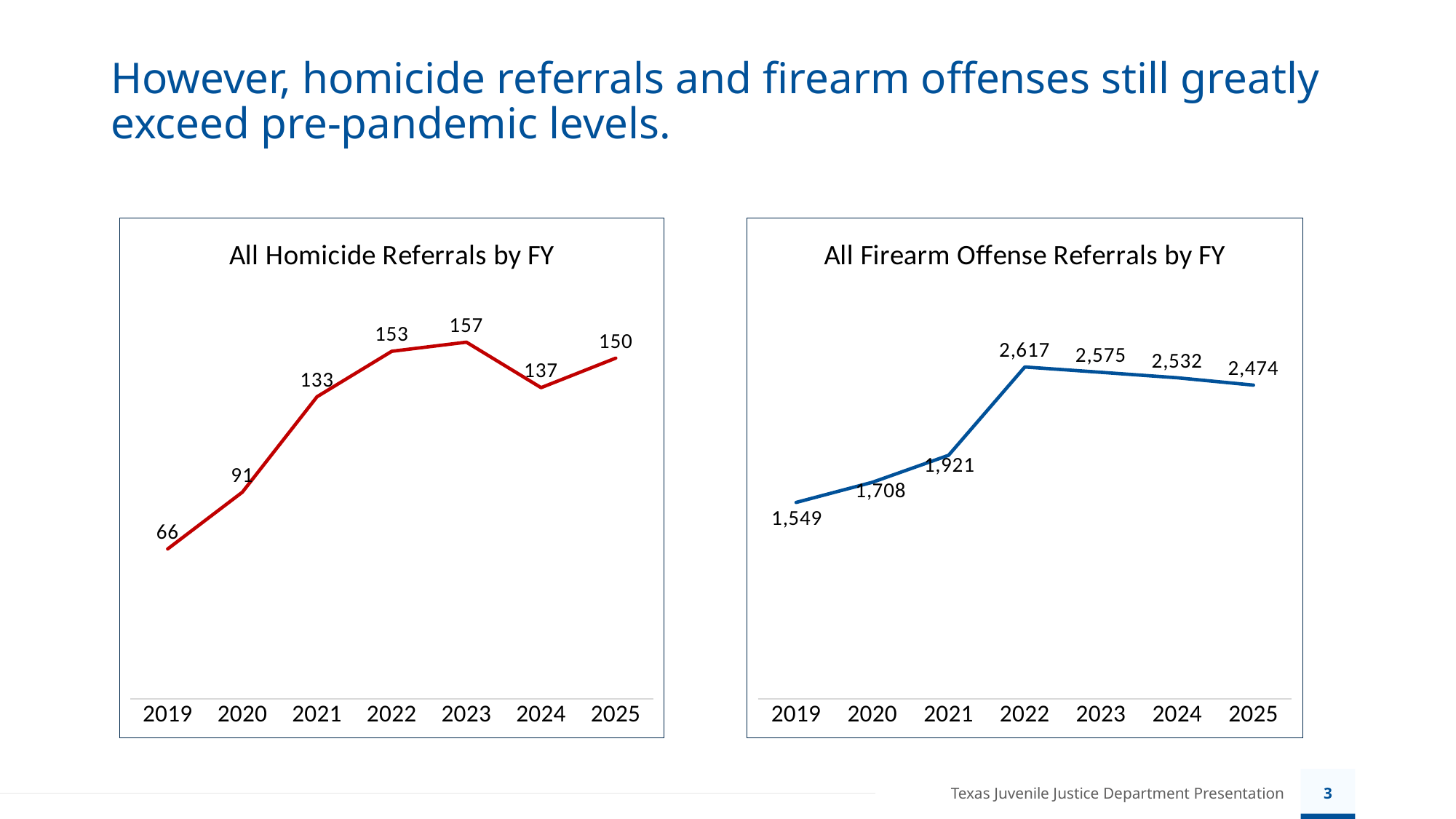
In the 'All Firearm Offense Referrals by FY' chart, which is larger, the value for 2020 or the value for 2021? 2021 In the 'All Firearm Offense Referrals by FY' chart, do the values rise or fall from 2022 to 2025? Fall In the 'All Firearm Offense Referrals by FY' chart, what is the value for 2022? 2,617 In the 'All Homicide Referrals by FY' chart, which year has the highest value? 2023 In the 'All Homicide Referrals by FY' chart, what is the difference between the 2025 value and the 2019 value? 84 How many years are plotted on the x axis of the 'All Homicide Referrals by FY' chart? 7 In the 'All Homicide Referrals by FY' chart, what is the value for 2021? 133 In the 'All Homicide Referrals by FY' chart, which is larger, the value for 2022 or the value for 2024? 2022 In the 'All Firearm Offense Referrals by FY' chart, what is the difference between the 2022 value and the 2025 value? 143 In the 'All Firearm Offense Referrals by FY' chart, which year has the lowest value? 2019 What colour is the line in the 'All Homicide Referrals by FY' chart? Red What kind of chart is the 'All Firearm Offense Referrals by FY' chart? Line chart